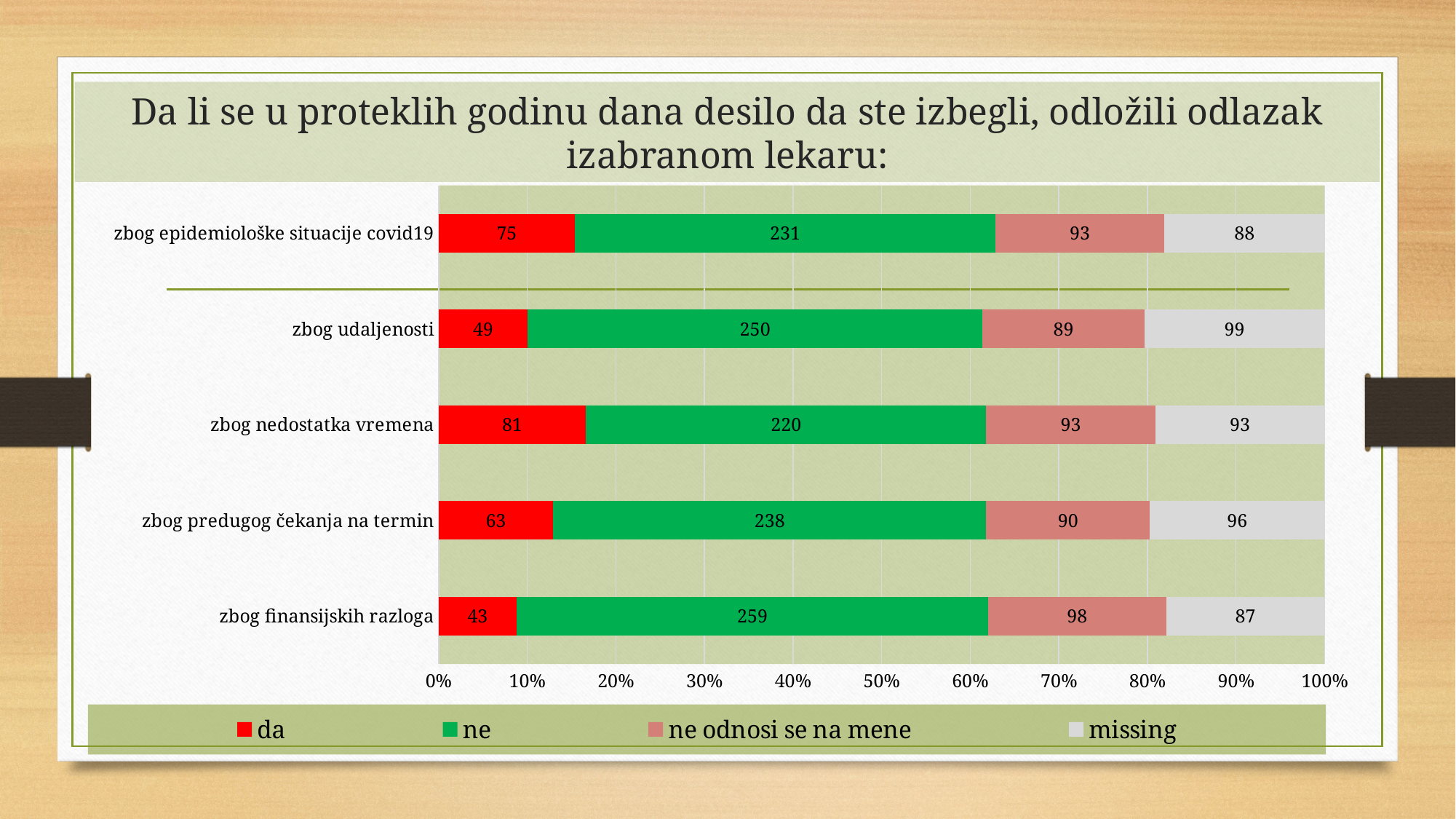
What is the value of "da" for "zbog epidemiološke situacije covid19"? 75 Which category has the lowest "da" value? zbog finansijskih razloga How many series does the legend list? 4 How many categories are shown on the chart? 5 Which colour represents the "ne" series in the legend? green Which is larger: the "da" value for "zbog udaljenosti" or for "zbog predugog čekanja na termin"? zbog predugog čekanja na termin What is the value of "ne" for "zbog finansijskih razloga"? 259 Which category has the highest "da" value? zbog nedostatka vremena What is the "missing" value for "zbog udaljenosti"? 99 What is the difference between the "ne" values for "zbog finansijskih razloga" and "zbog nedostatka vremena"? 39 What is the total of all segments in the bar for "zbog nedostatka vremena"? 487 What kind of chart is shown on the slide? stacked bar chart